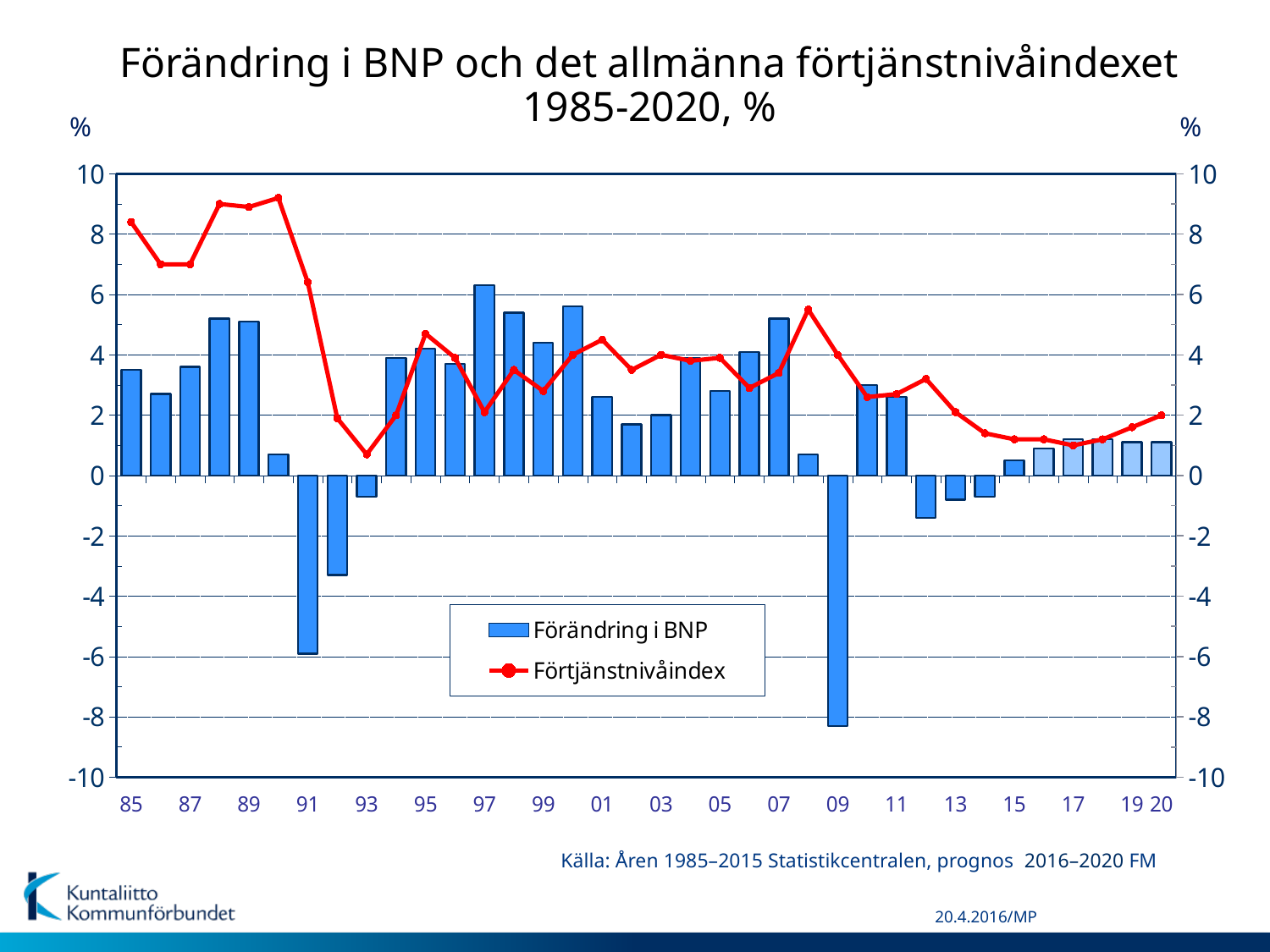
Does the Förtjänstnivåindex line overall rise or fall between 1985 and 1993? fall Which year has the higher Förtjänstnivåindex value, 1990 or 1993? 1990 In which year is the Förändring i BNP bar lowest? 2009 Is the Förändring i BNP value for 2009 greater or less than -6? less Is the Förändring i BNP value for 1991 greater or less than -4? less In which year is the Förändring i BNP bar highest? 1997 What are the two entries in the legend? Förändring i BNP and Förtjänstnivåindex What colour is the Förtjänstnivåindex line? Red Which year has the larger Förändring i BNP bar, 1988 or 1990? 1988 What kind of chart is shown on the slide? A combined bar and line chart How many series does the legend list? 2 Is the Förtjänstnivåindex value for 1985 greater or less than 8? greater